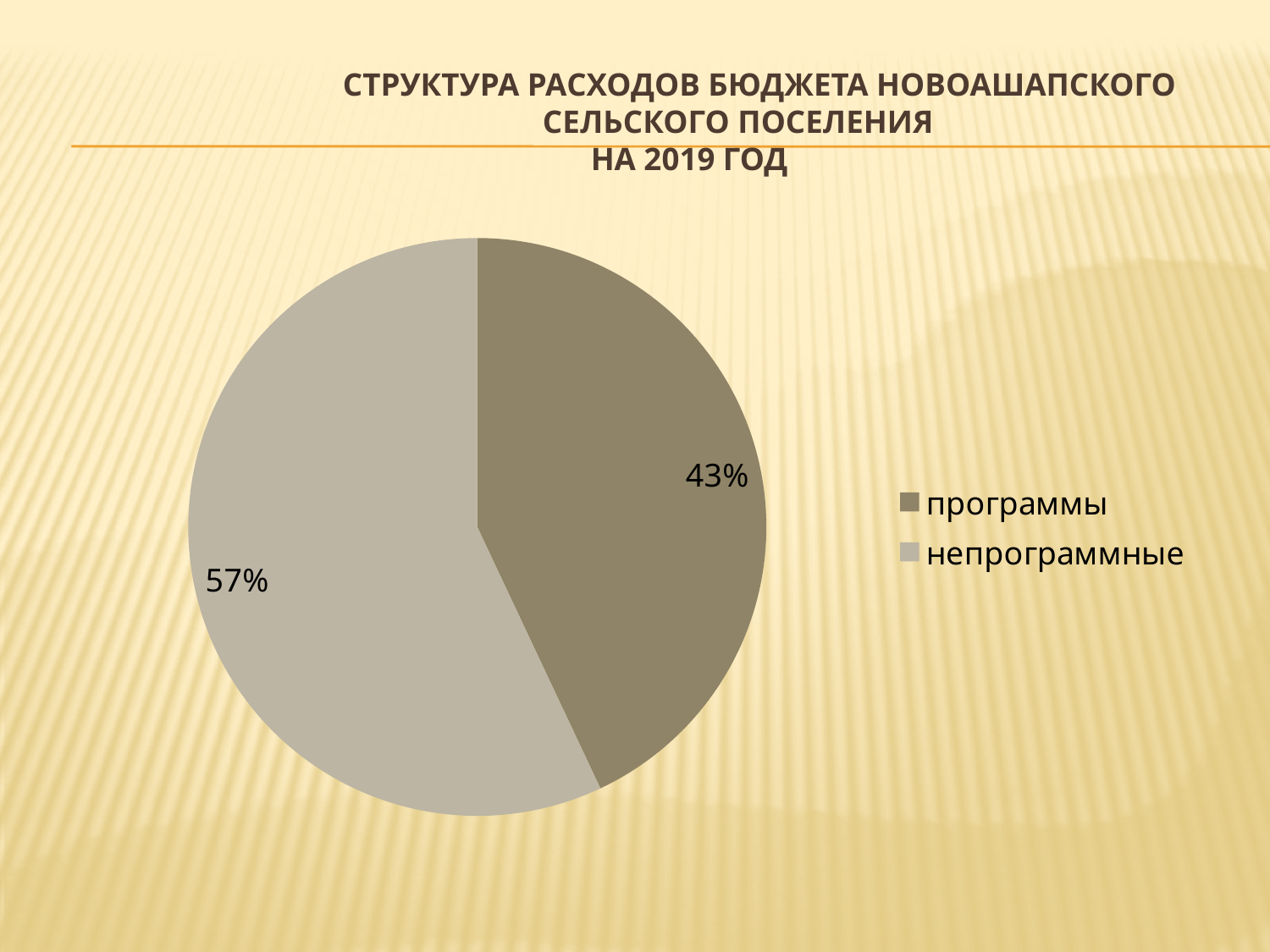
What is the difference in percentage points between the 'непрограммные' and 'программы' slices? 14% Which category has the largest share of the pie? непрограммные What share of the pie does the 'непрограммные' slice represent? 57% Which year does the chart title refer to? 2019 What share of the pie does the 'программы' slice represent? 43% How many entries does the legend list? 2 Which legend entry is shown with the darker colour? программы What kind of chart is shown on the slide? pie chart What is the total of the two slices shown on the pie chart? 100% Which is larger: the share for 'программы' or the share for 'непрограммные'? непрограммные Which category has the smallest share of the pie? программы How many slices does the pie chart have? 2